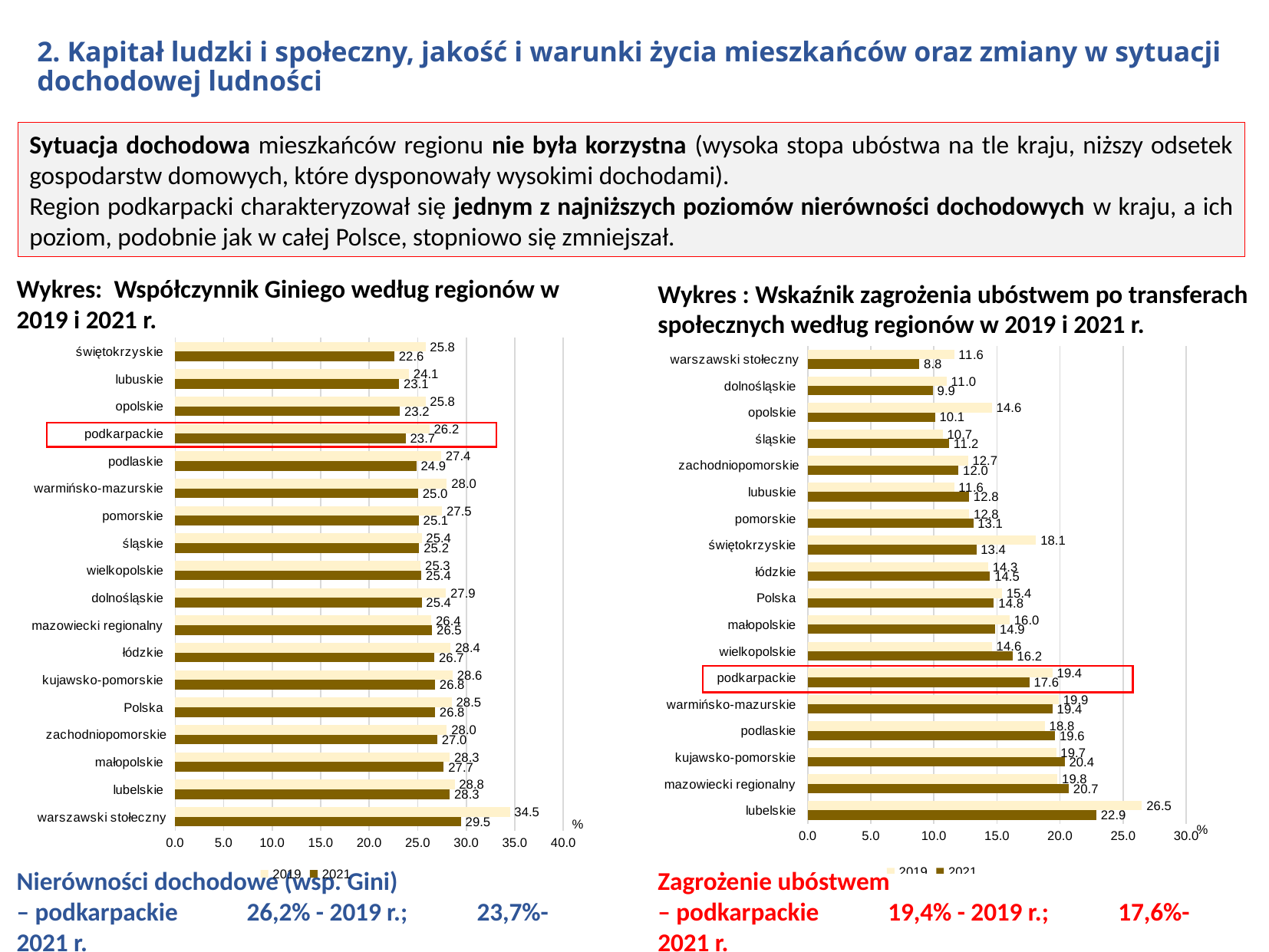
In the right chart (Wskaźnik zagrożenia ubóstwem po transferach społecznych), what is the value for podkarpackie in 2019? 19.4 In the left chart (Współczynnik Giniego według regionów), which region has the lowest value in 2021? świętokrzyskie In the right chart (Wskaźnik zagrożenia ubóstwem po transferach społecznych), how many series does the legend list? 2 In the left chart (Współczynnik Giniego według regionów), which region has the highest value in 2019? warszawski stołeczny In the left chart (Współczynnik Giniego według regionów), how many regions (categories) are shown? 18 In the left chart (Współczynnik Giniego według regionów), what is the value for podkarpackie in 2021? 23.7 In the left chart (Współczynnik Giniego według regionów), what is the difference between the 2019 and 2021 values for podkarpackie? 2.5 In the left chart (Współczynnik Giniego według regionów), what is the value for warszawski stołeczny in 2019? 34.5 In the right chart (Wskaźnik zagrożenia ubóstwem po transferach społecznych), which region has the lowest value in 2021? warszawski stołeczny In the right chart (Wskaźnik zagrożenia ubóstwem po transferach społecznych), is the 2021 value for podkarpackie larger or smaller than the 2021 value for Polska? larger What type of chart is the right chart (Wskaźnik zagrożenia ubóstwem po transferach społecznych)? bar chart In the right chart (Wskaźnik zagrożenia ubóstwem po transferach społecznych), which region has the highest value in 2021? lubelskie